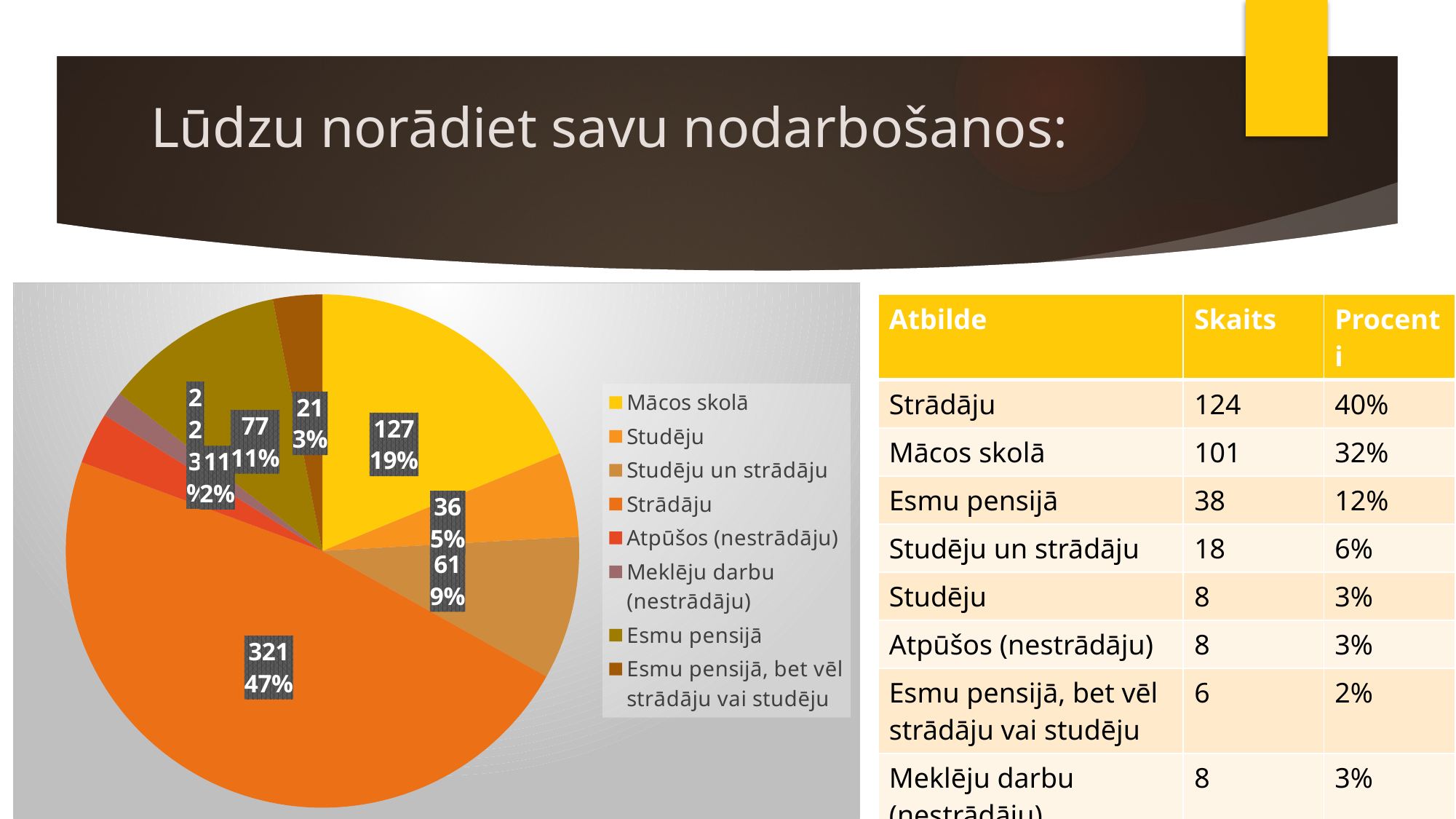
Which category has the largest slice in the pie chart? Strādāju What value is shown on the pie chart for Strādāju? 321 What percentage share does the pie chart show for Mācos skolā? 19% In the pie chart, what is the difference between the value for Mācos skolā (127) and the value for Studēju (36)? 91 What percentage share does the pie chart show for Esmu pensijā? 11% What type of chart is shown on the slide? pie chart What value is shown on the pie chart for Mācos skolā? 127 How many categories does the pie chart's legend list? 8 In the pie chart, which is larger: the value for Mācos skolā or the value for Studēju? Mācos skolā What colour is the Strādāju slice in the pie chart? orange What value is shown on the pie chart for Studēju un strādāju? 61 What percentage share does the pie chart show for Strādāju? 47%